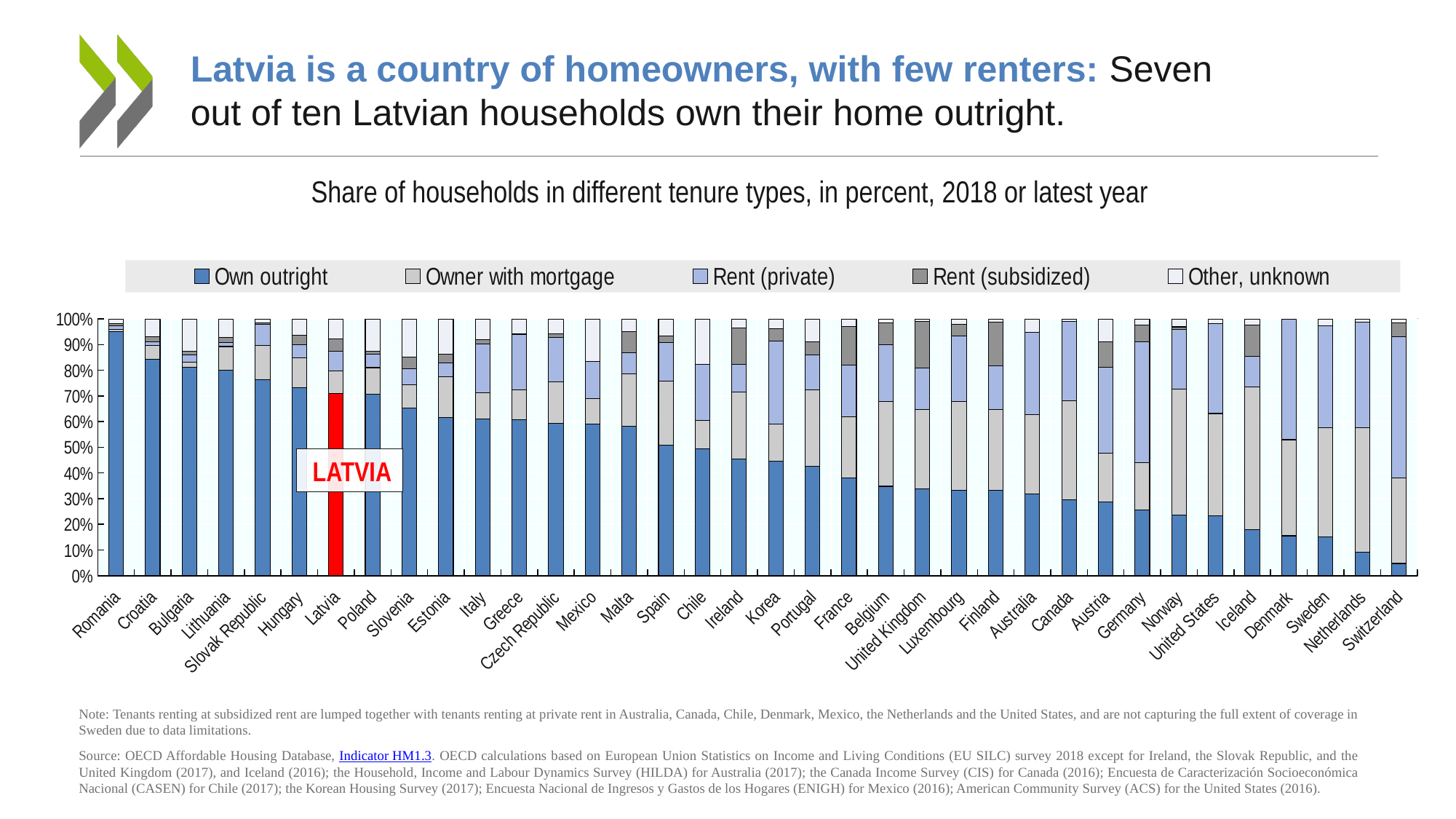
Which country has the highest share of households that own their home outright? Romania Is the 'Own outright' share for Latvia greater or less than 60%? greater Is the 'Own outright' share for Romania greater or less than 90%? greater How many countries are shown on the x axis? 36 Which country has a larger 'Own outright' share, Croatia or Spain? Croatia What kind of chart is shown on the slide? Stacked bar chart Does the 'Own outright' share rise or fall moving from left to right along the x axis? Fall Is the 'Own outright' share for Germany greater or less than 30%? less How many series does the legend list? 5 What is the title of the chart? Share of households in different tenure types, in percent, 2018 or latest year Which country's bar is highlighted in red? Latvia Which country has the lowest share of households that own their home outright? Switzerland